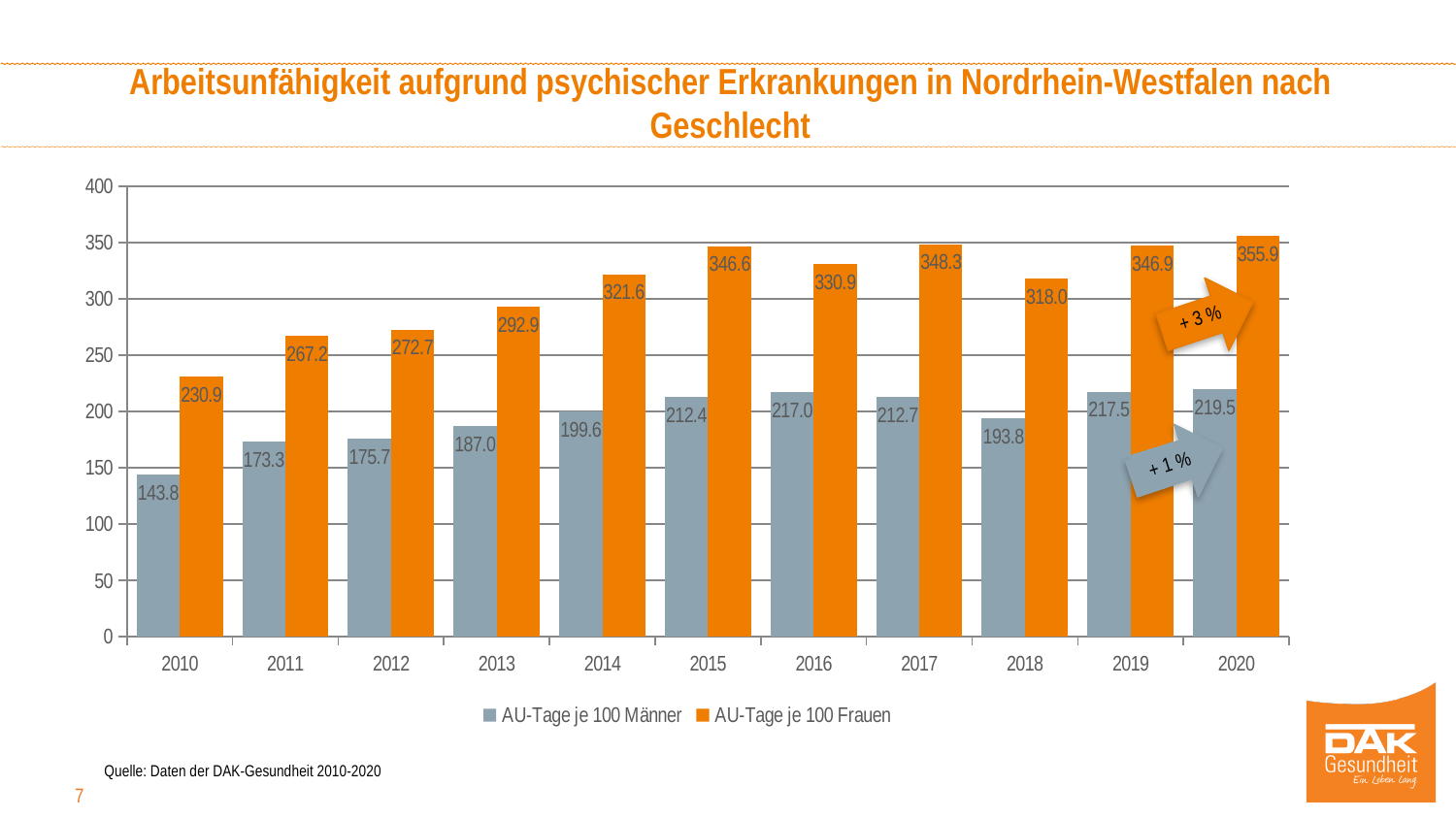
In which year is the value for AU-Tage je 100 Männer the lowest? 2010 What kind of chart is shown on the slide? bar chart Which is larger: AU-Tage je 100 Frauen in 2015 or in 2016? 2015 Is the value for AU-Tage je 100 Männer in 2014 greater or less than 200? less What is the value for AU-Tage je 100 Frauen in 2020? 355.9 In which year is the value for AU-Tage je 100 Frauen the highest? 2020 Which colour represents AU-Tage je 100 Frauen in the chart? orange What is the difference between AU-Tage je 100 Frauen and AU-Tage je 100 Männer in 2020? 136.4 What is the value for AU-Tage je 100 Männer in 2018? 193.8 How many series does the legend list? 2 What is the value for AU-Tage je 100 Männer in 2010? 143.8 How many years are shown on the x axis? 11